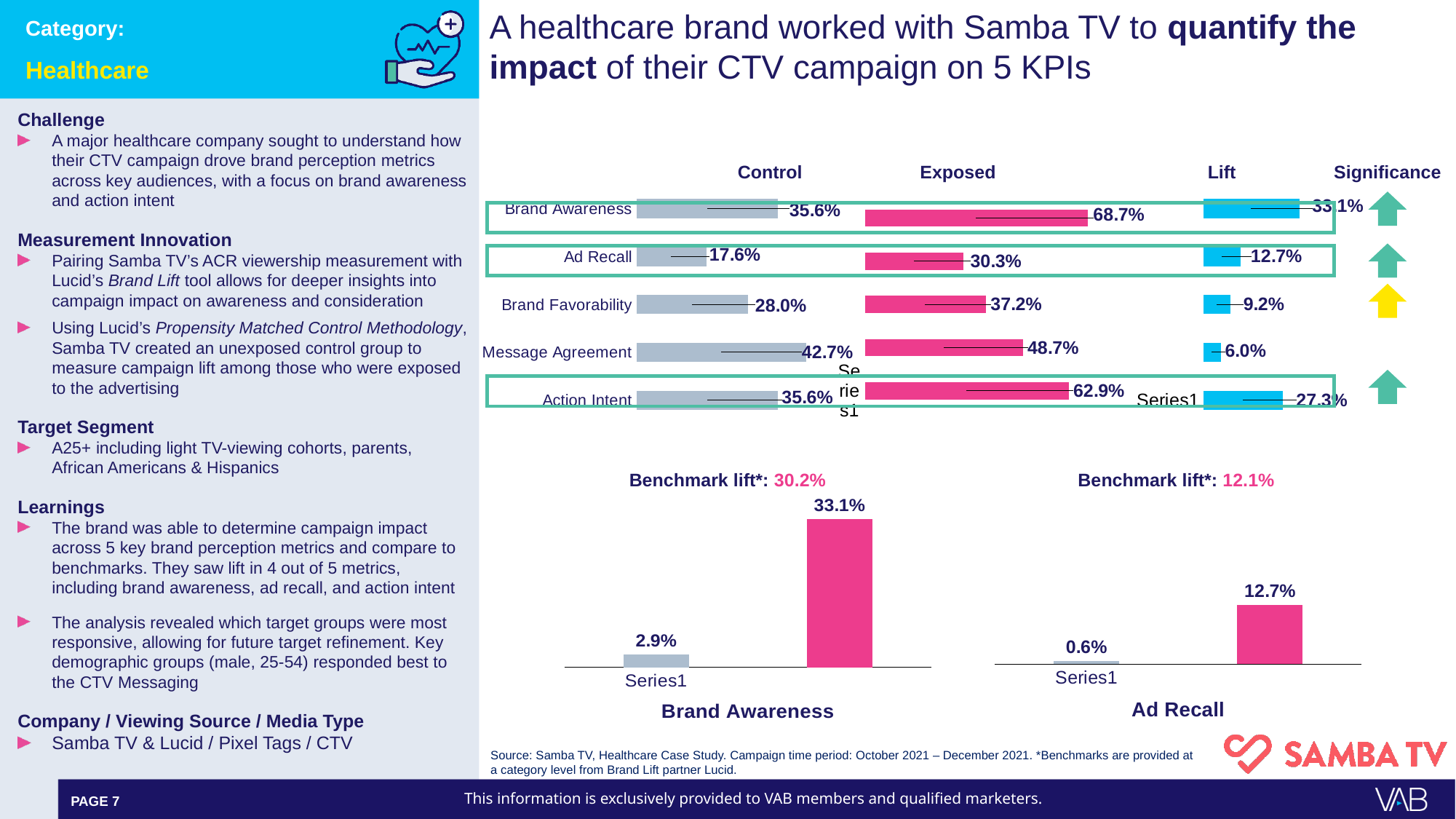
In the top chart, which KPI has the lowest Lift? Message Agreement In the top chart, which KPI has the highest Lift? Brand Awareness In the top chart, which KPI has the highest Exposed value? Brand Awareness In the bottom-right Ad Recall chart, what is the value of the grey bar? 0.6% In the top chart, what is the Control value for Ad Recall? 17.6% How many KPIs are listed in the top chart? 5 What type of chart is the bottom-left Brand Awareness chart? Bar chart In the top chart, which has the larger Control value: Message Agreement or Brand Favorability? Message Agreement In the bottom-left Brand Awareness chart, what is the value of the pink bar? 33.1% In the bottom-right Ad Recall chart, what is the difference between the pink bar and the grey bar? 12.1% In the top chart, what is the difference between the Exposed and Control values for Action Intent? 27.3% In the top chart, what is the Exposed value for Brand Awareness? 68.7%